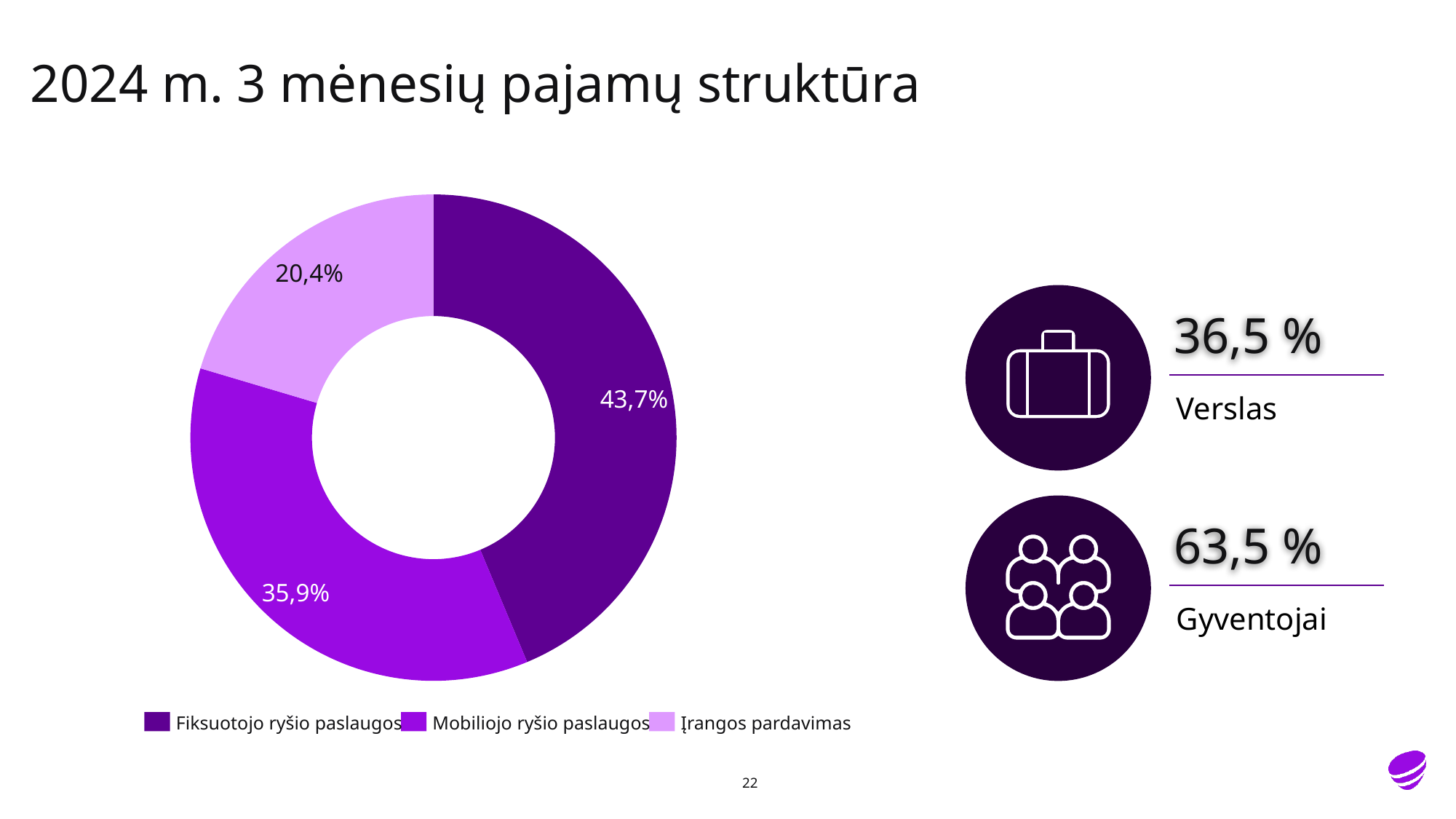
What share of revenue does Fiksuotojo ryšio paslaugos account for in the donut chart? 43,7% What is the title of the slide containing the chart? 2024 m. 3 mėnesių pajamų struktūra What share of revenue does Mobiliojo ryšio paslaugos account for in the donut chart? 35,9% What is the difference in percentage points between Mobiliojo ryšio paslaugos and Įrangos pardavimas? 15,5 What share of revenue does Įrangos pardavimas account for in the donut chart? 20,4% How many categories are shown in the donut chart? 3 Which is larger: the share for Mobiliojo ryšio paslaugos or for Įrangos pardavimas? Mobiliojo ryšio paslaugos Which category has the smallest share in the donut chart? Įrangos pardavimas Which category has the largest share in the donut chart? Fiksuotojo ryšio paslaugos Which category is shown in the lightest purple colour in the donut chart? Įrangos pardavimas What is the difference in percentage points between Fiksuotojo ryšio paslaugos and Mobiliojo ryšio paslaugos? 7,8 What kind of chart is shown on the slide? Donut (pie) chart